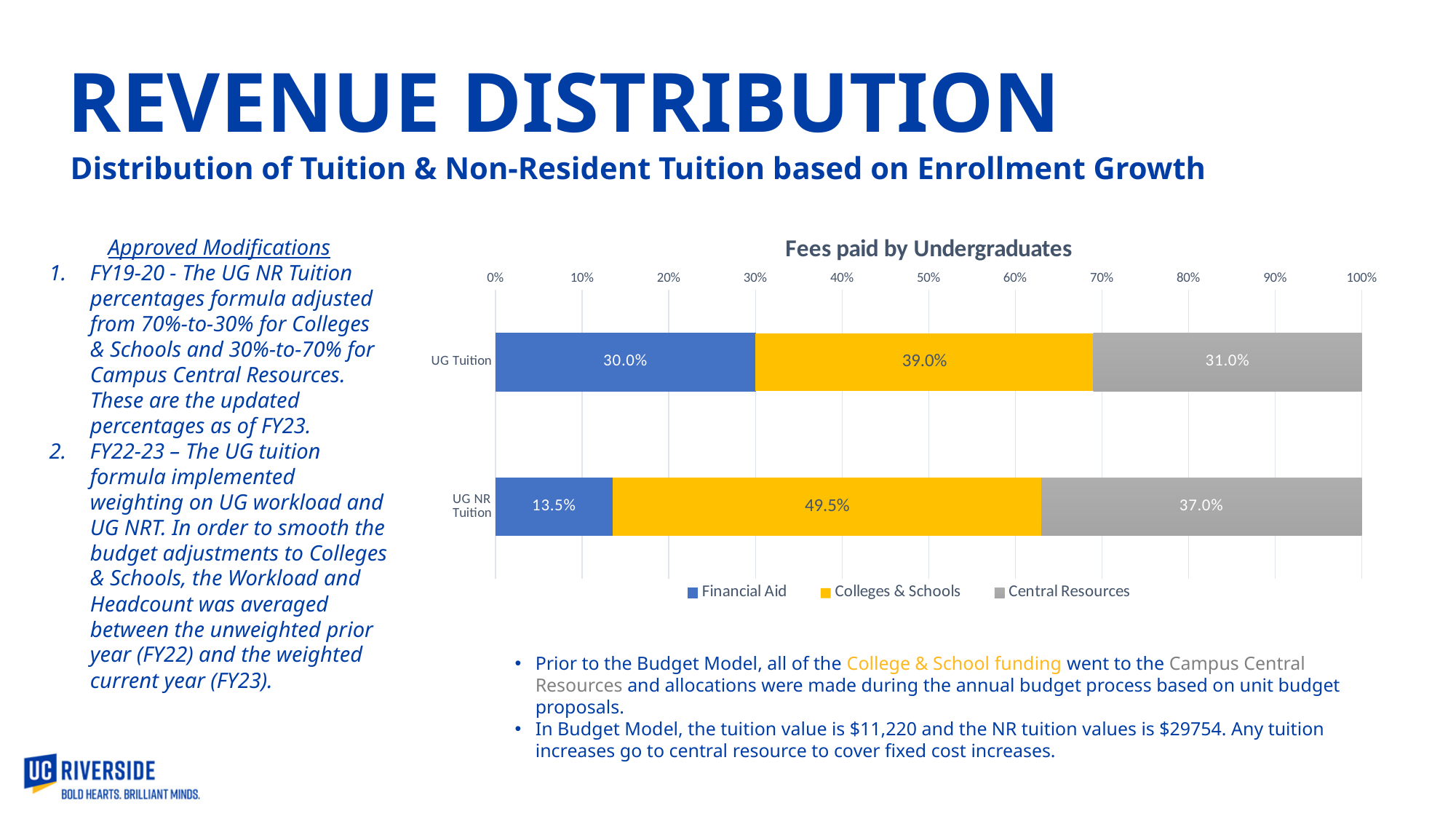
How many series does the legend list? 3 What is the Financial Aid value for UG Tuition? 30.0% How many categories are shown on the chart? 2 What is the title of the chart? Fees paid by Undergraduates Is the Financial Aid value for UG Tuition or for UG NR Tuition larger? UG Tuition Which category has the higher Central Resources value? UG NR Tuition What kind of chart is shown on the slide? Stacked bar chart What is the difference between the Colleges & Schools values for UG NR Tuition and UG Tuition? 10.5% What is the Financial Aid value for UG NR Tuition? 13.5% Which category has the lower Financial Aid value? UG NR Tuition What is the Colleges & Schools value for UG NR Tuition? 49.5% What is the Central Resources value for UG Tuition? 31.0%